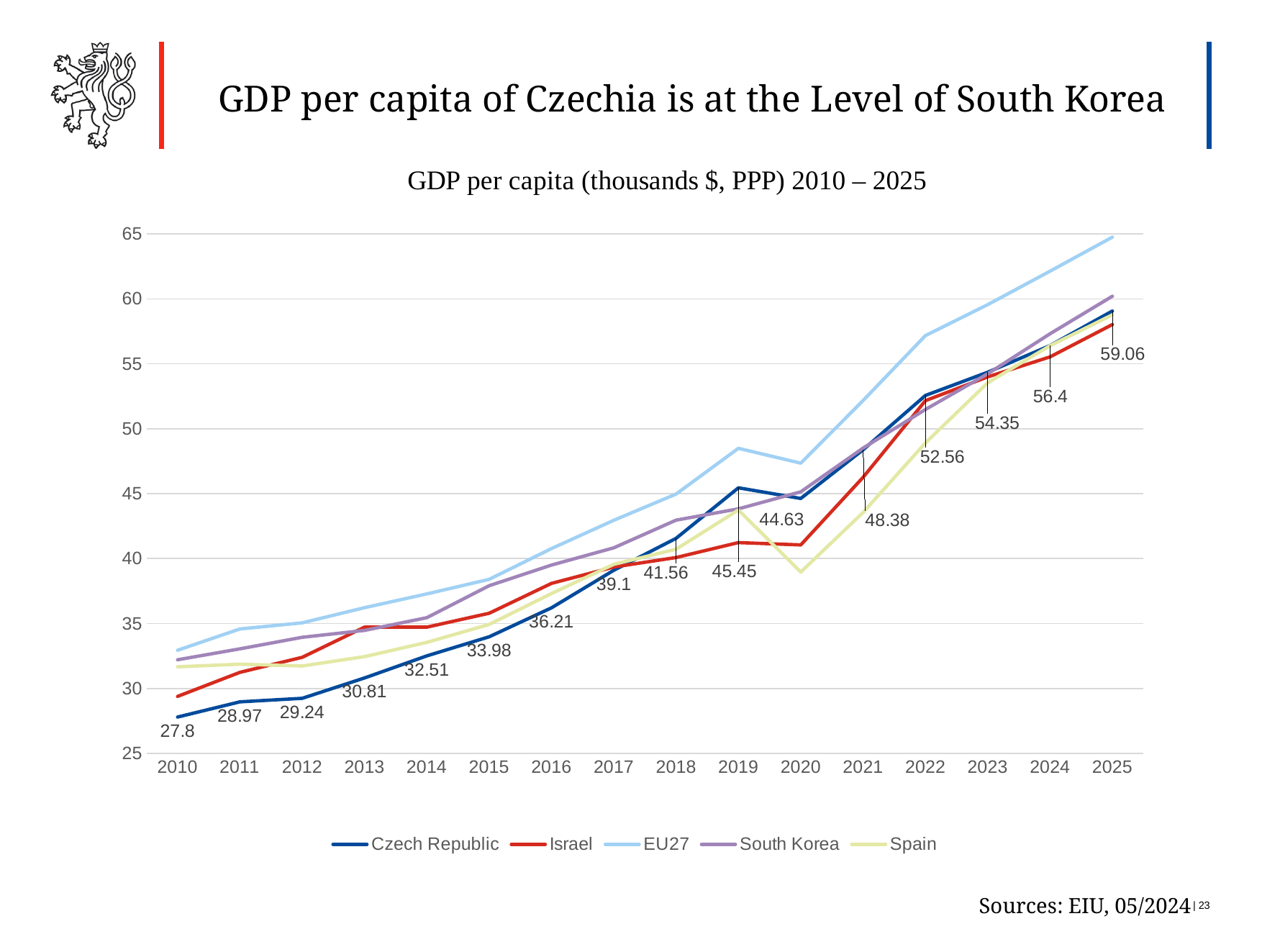
What is the difference between the Czech Republic's values in 2025 and 2010? 31.26 Which series has the highest value in 2025? EU27 What is the GDP per capita value for the Czech Republic in 2022? 52.56 How many years are shown on the x axis? 16 Is the value for Spain in 2020 greater or less than 40? less What type of chart is shown on the slide? line chart Which is larger for the Czech Republic: the value in 2019 or the value in 2020? 2019 What is the GDP per capita value for the Czech Republic in 2019? 45.45 What is the title of the chart? GDP per capita (thousands $, PPP) 2010 – 2025 What is the GDP per capita value for the Czech Republic in 2025? 59.06 What is the GDP per capita value for the Czech Republic in 2010? 27.8 How many series does the legend list? 5